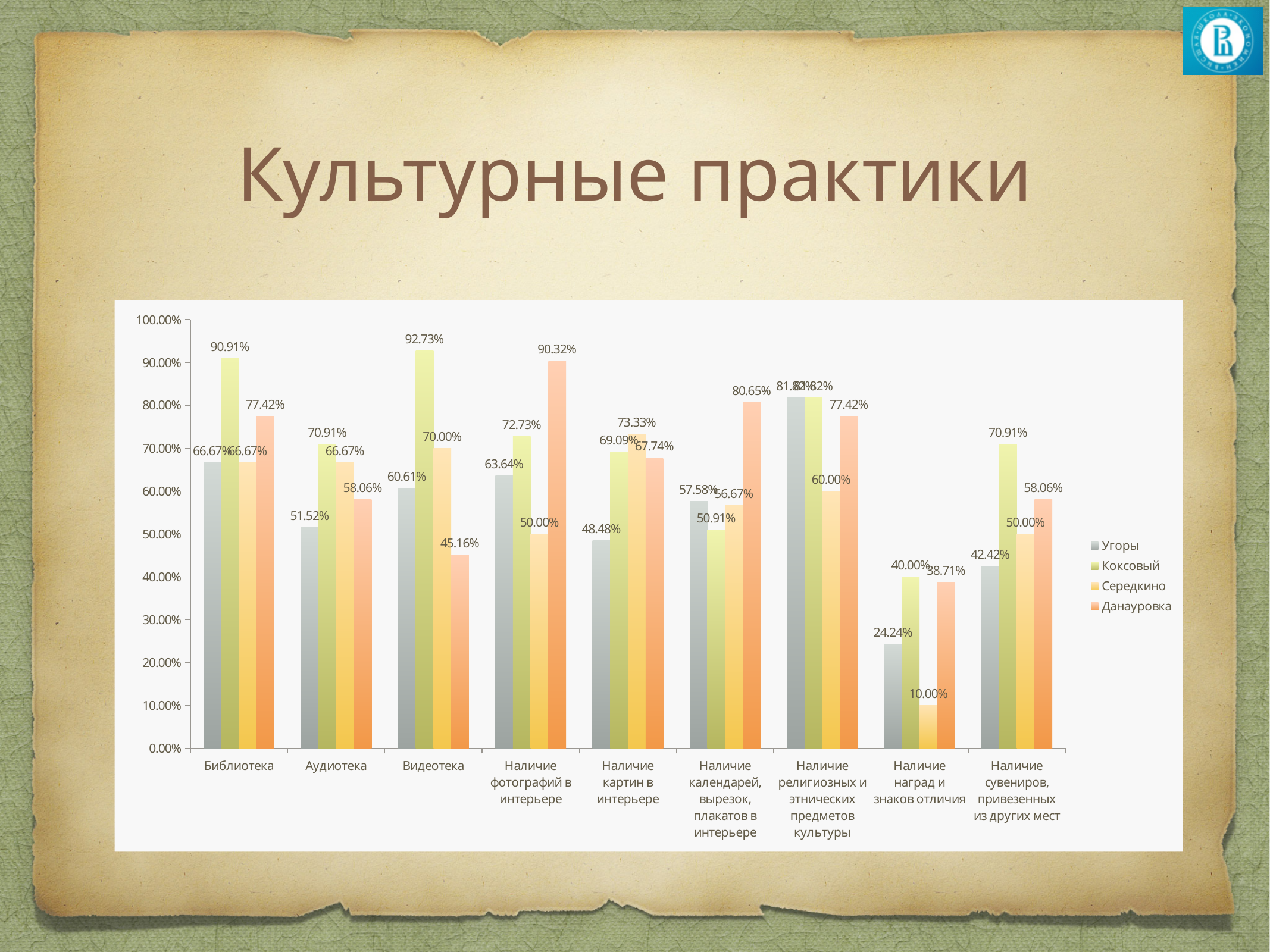
Which is larger in the Аудиотека category: Угоры or Данауровка? Данауровка Is the value for Угоры in the Наличие сувениров, привезенных из других мест category greater or less than 50.00%? less How many categories are shown on the x axis? 9 How many series does the legend list? 4 What is the value for Середкино in the Наличие наград и знаков отличия category? 10.00% What is the value for Коксовый in the Видеотека category? 92.73% What is the title of the slide? Культурные практики What type of chart is shown on the slide? Bar chart Which series has the highest value in the Наличие календарей, вырезок, плакатов в интерьере category? Данауровка What is the value for Данауровка in the Наличие фотографий в интерьере category? 90.32% What is the difference between Коксовый and Угоры in the Библиотека category? 24.24% Which series has the lowest value in the Наличие наград и знаков отличия category? Середкино